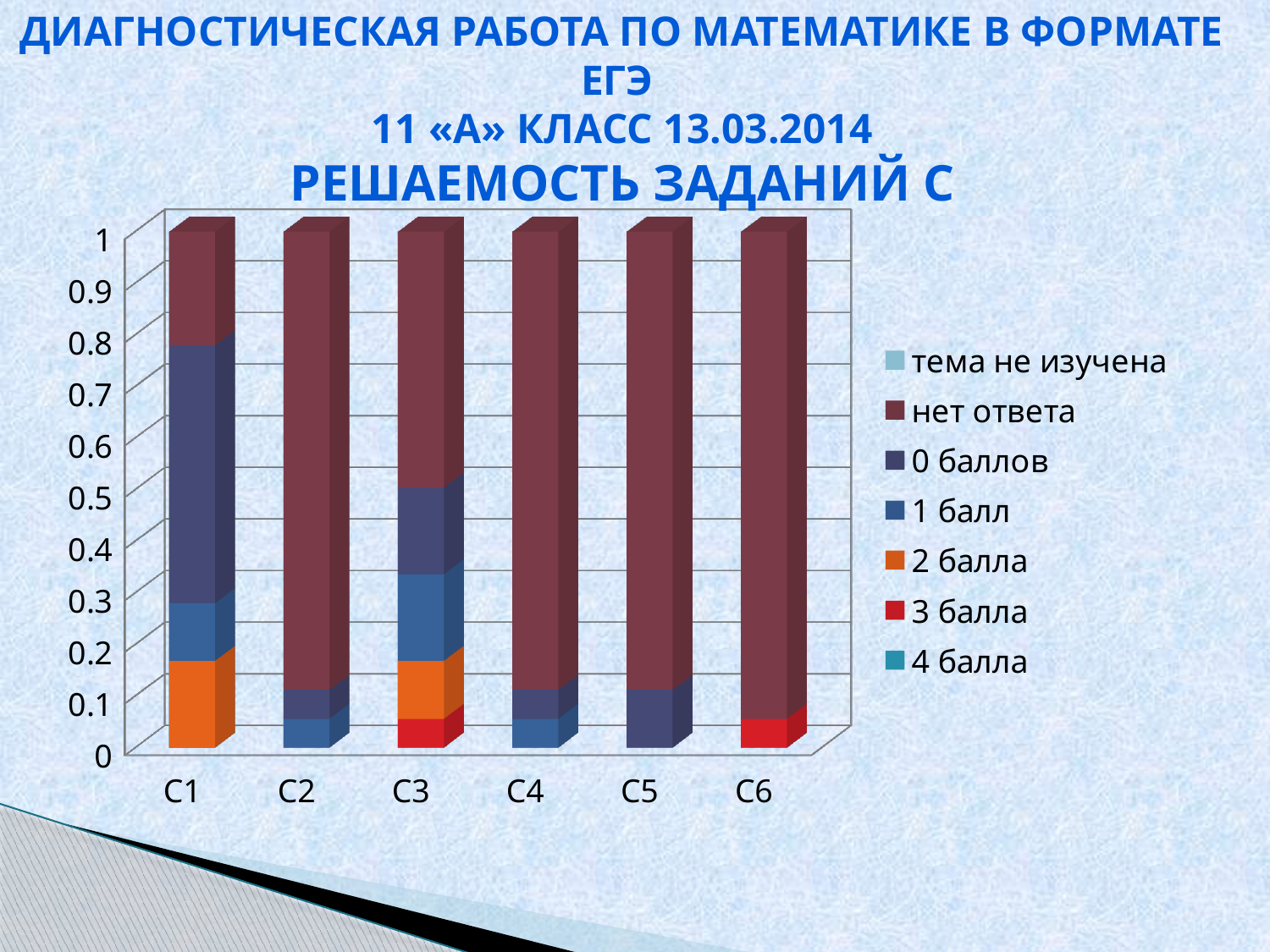
How many categories are shown on the x axis of the chart? 6 Is the 'нет ответа' share for С6 greater or less than 0.8? greater Which is larger, the '0 баллов' share for С1 or for С2? С1 Is the 'нет ответа' share for С2 greater or less than 0.7? greater Is the 'нет ответа' share for С1 greater or less than 0.5? less How many series does the chart legend list? 7 Which category has the largest '0 баллов' share? С1 Which category has the smallest 'нет ответа' share? С1 What kind of chart is shown on the slide? stacked bar chart Which categories contain a '3 балла' segment? С3 and С6 What is the title of the chart? РЕШАЕМОСТЬ ЗАДАНИЙ С What is the total height of the stacked bar for С1? 1